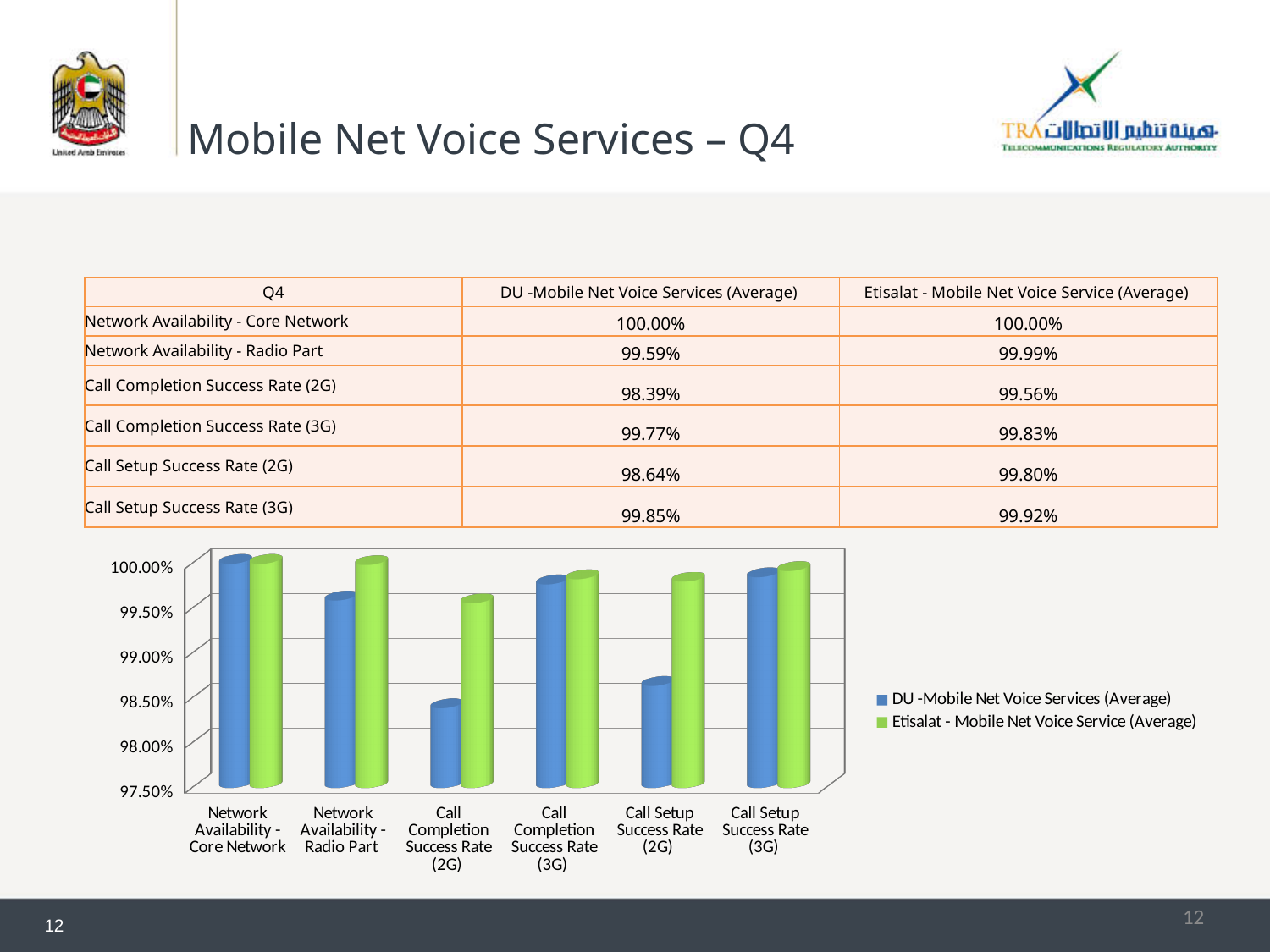
How many series does the chart legend list? 2 Is the DU value for Call Completion Success Rate (2G) greater or less than 98.50%? less What is the DU value for Call Completion Success Rate (2G)? 98.39% Which category has the lowest value for DU - Mobile Net Voice Services (Average)? Call Completion Success Rate (2G) For Network Availability - Radio Part, which series has the larger value, DU or Etisalat? Etisalat Which category has the lowest value for Etisalat - Mobile Net Voice Service (Average)? Call Completion Success Rate (2G) For Call Setup Success Rate (2G), what is the difference between the Etisalat value and the DU value? 1.16% Which colour represents Etisalat - Mobile Net Voice Service (Average) in the chart? green How many categories are shown along the x axis of the chart? 6 What is the Etisalat value for Network Availability - Radio Part? 99.99% What is the DU value for Call Setup Success Rate (3G)? 99.85% What type of chart is shown on the slide? bar chart